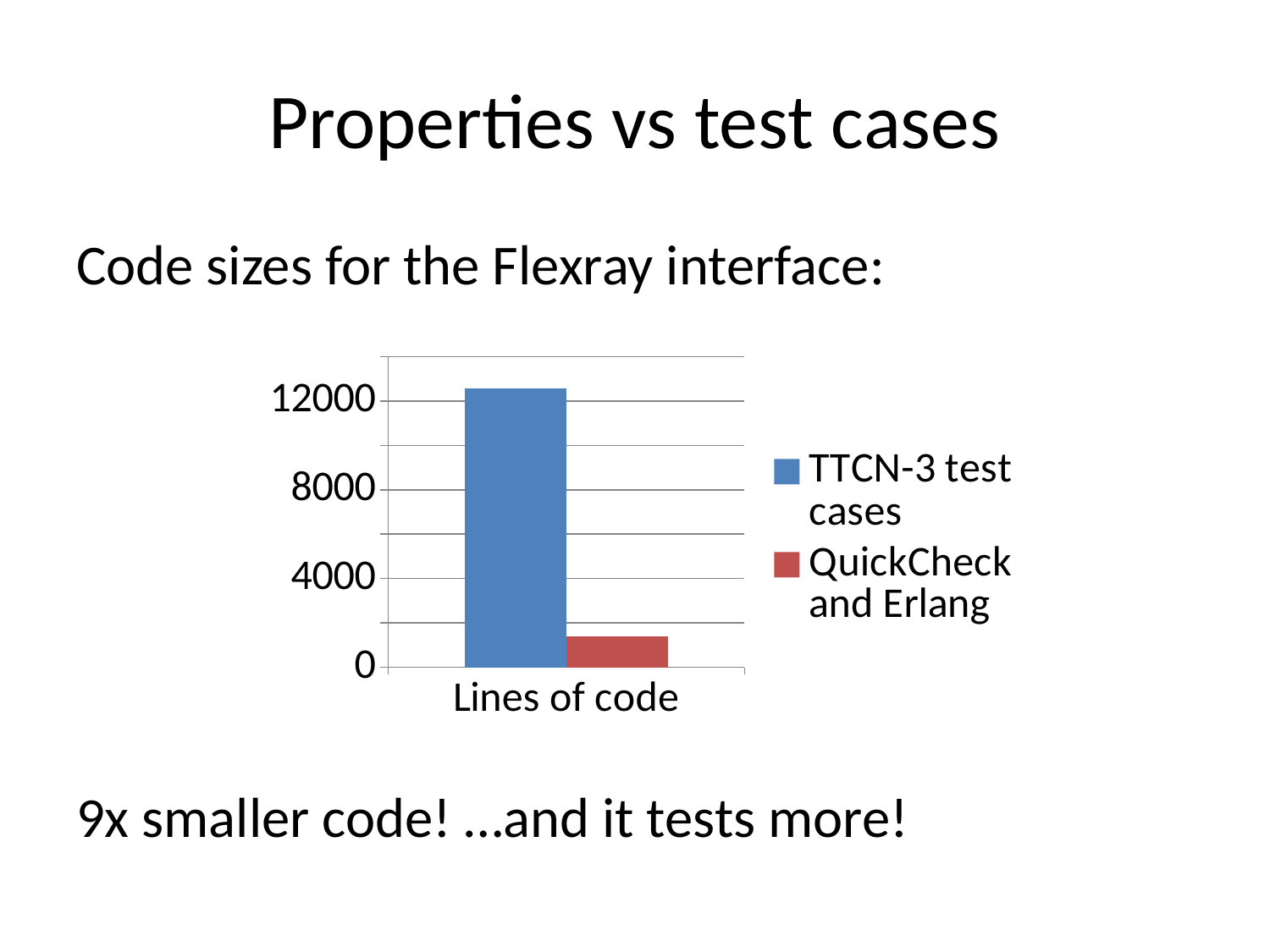
What is the highest value labelled on the y axis of the chart? 12000 Is the value for QuickCheck and Erlang greater or less than 4000? less What kind of chart is shown on the slide? bar chart How many categories are plotted on the x axis of the chart? 1 Which series has the lowest bar in the chart? QuickCheck and Erlang What colour is the bar for QuickCheck and Erlang in the chart? red Which series has the larger value for Lines of code, TTCN-3 test cases or QuickCheck and Erlang? TTCN-3 test cases Which series has the highest bar in the chart? TTCN-3 test cases Is the value for TTCN-3 test cases greater or less than 8000? greater Is the value for TTCN-3 test cases greater or less than 12000? greater What is the category label on the x axis of the chart? Lines of code How many series does the chart's legend list? 2